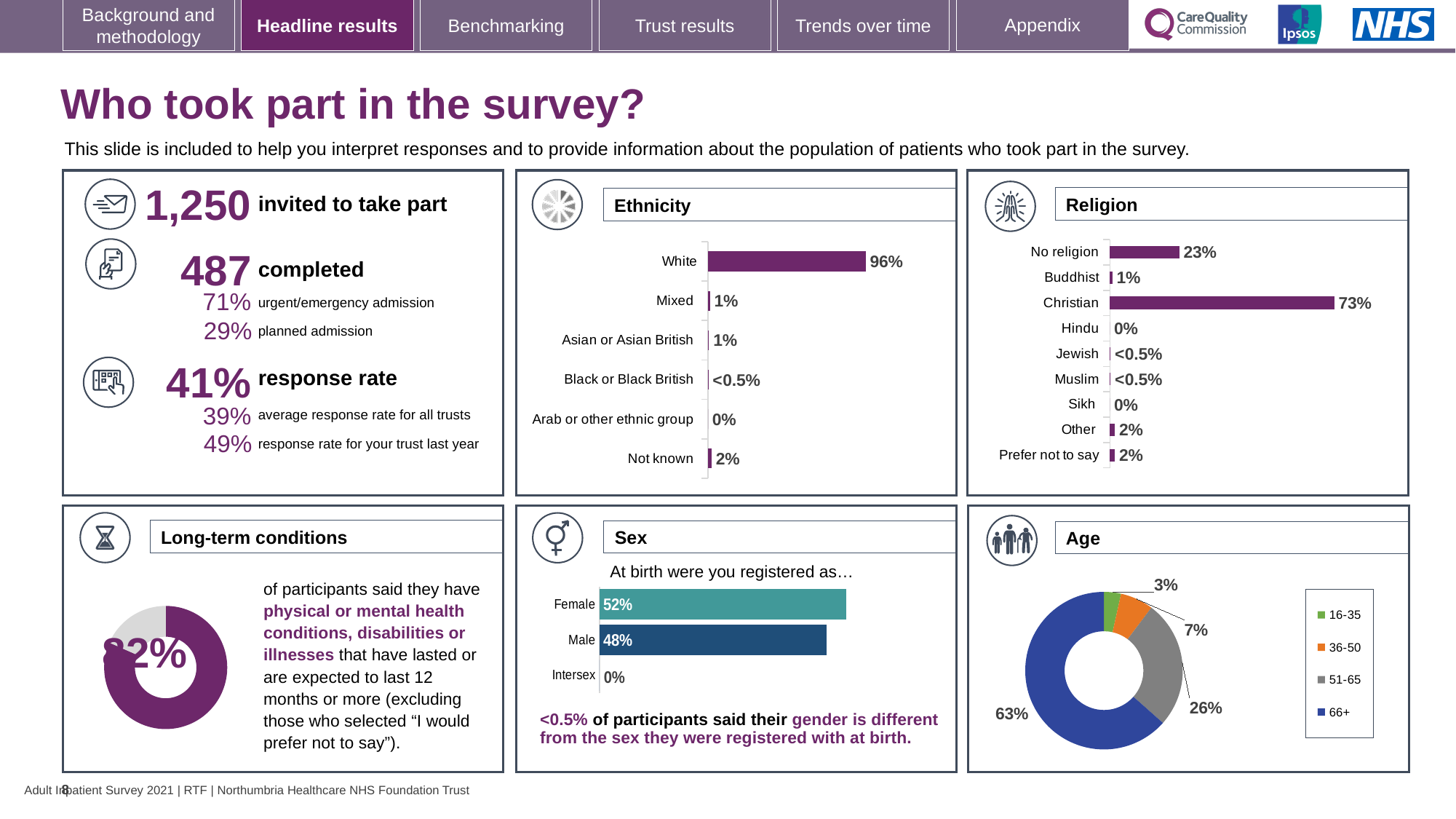
In the Religion chart, what is the difference between the Christian and No religion percentages? 50% In the Sex chart, what percentage of participants were registered as Female at birth? 52% In the Ethnicity chart, what is the value for Not known? 2% How many categories are shown in the Religion chart? 9 In the Sex chart, which is larger, Female or Male? Female In the Ethnicity chart, which ethnic group has the highest percentage? White How many categories are shown in the Ethnicity chart? 6 In the Religion chart, what percentage of participants were Christian? 73% In the Age chart, what share of participants were aged 66+? 63% What kind of chart is the Age chart? Doughnut chart In the Religion chart, which category has the highest value? Christian In the Ethnicity chart, what percentage of participants were White? 96%